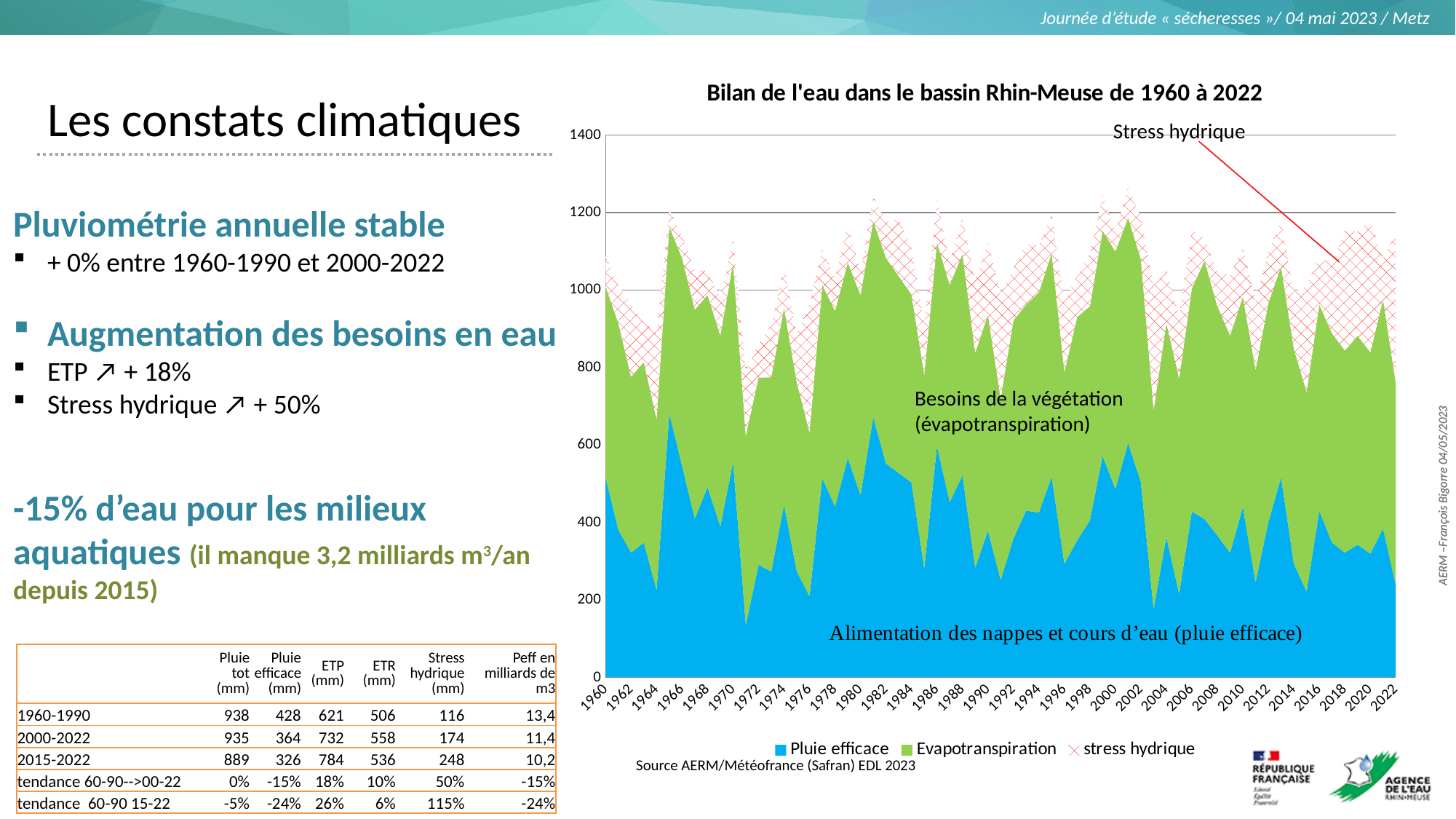
Is the top of the stacked area in 1966 greater or less than 1000? greater Is the top of the stacked area in 1971 greater or less than 1000? less How many series does the chart legend list? 3 Is the value of Pluie efficace in 1981 greater or less than 600? greater What is the first year shown on the x axis of the chart? 1960 What is the highest value shown on the y axis of the chart? 1400 Which series is shown in blue in the chart legend? Pluie efficace What is the title of the chart? Bilan de l'eau dans le bassin Rhin-Meuse de 1960 à 2022 Does the stress hydrique series rise or fall over the period shown on the chart? rise What kind of chart is shown on the slide? area chart